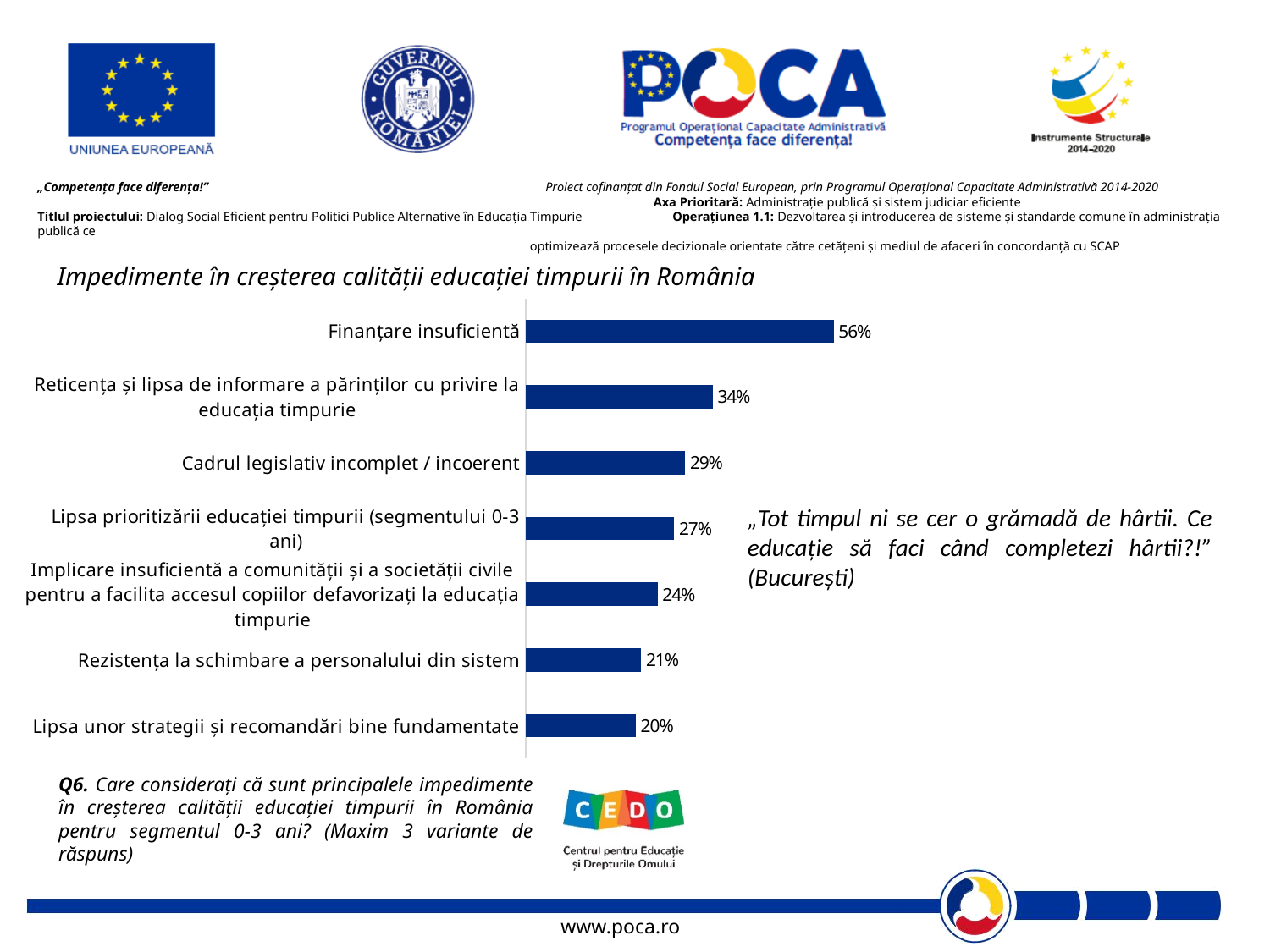
What is the title of the chart? Impedimente în creșterea calității educației timpurii în România What is the difference between the values for "Finanțare insuficientă" and "Reticența și lipsa de informare a părinților cu privire la educația timpurie"? 22% How many categories are shown in the chart? 7 What type of chart is shown on the slide? Bar chart Which category has the highest value in the chart? Finanțare insuficientă What colour are the bars in the chart? Blue What percentage is shown for "Rezistența la schimbare a personalului din sistem"? 21% What is the value for "Implicare insuficientă a comunității și a societății civile pentru a facilita accesul copiilor defavorizați la educația timpurie"? 24% Which is larger: the value for "Cadrul legislativ incomplet / incoerent" or the value for "Lipsa prioritizării educației timpurii (segmentului 0-3 ani)"? Cadrul legislativ incomplet / incoerent What value is shown for "Cadrul legislativ incomplet / incoerent"? 29% What percentage is shown for "Finanțare insuficientă"? 56% Which category has the lowest value in the chart? Lipsa unor strategii și recomandări bine fundamentate